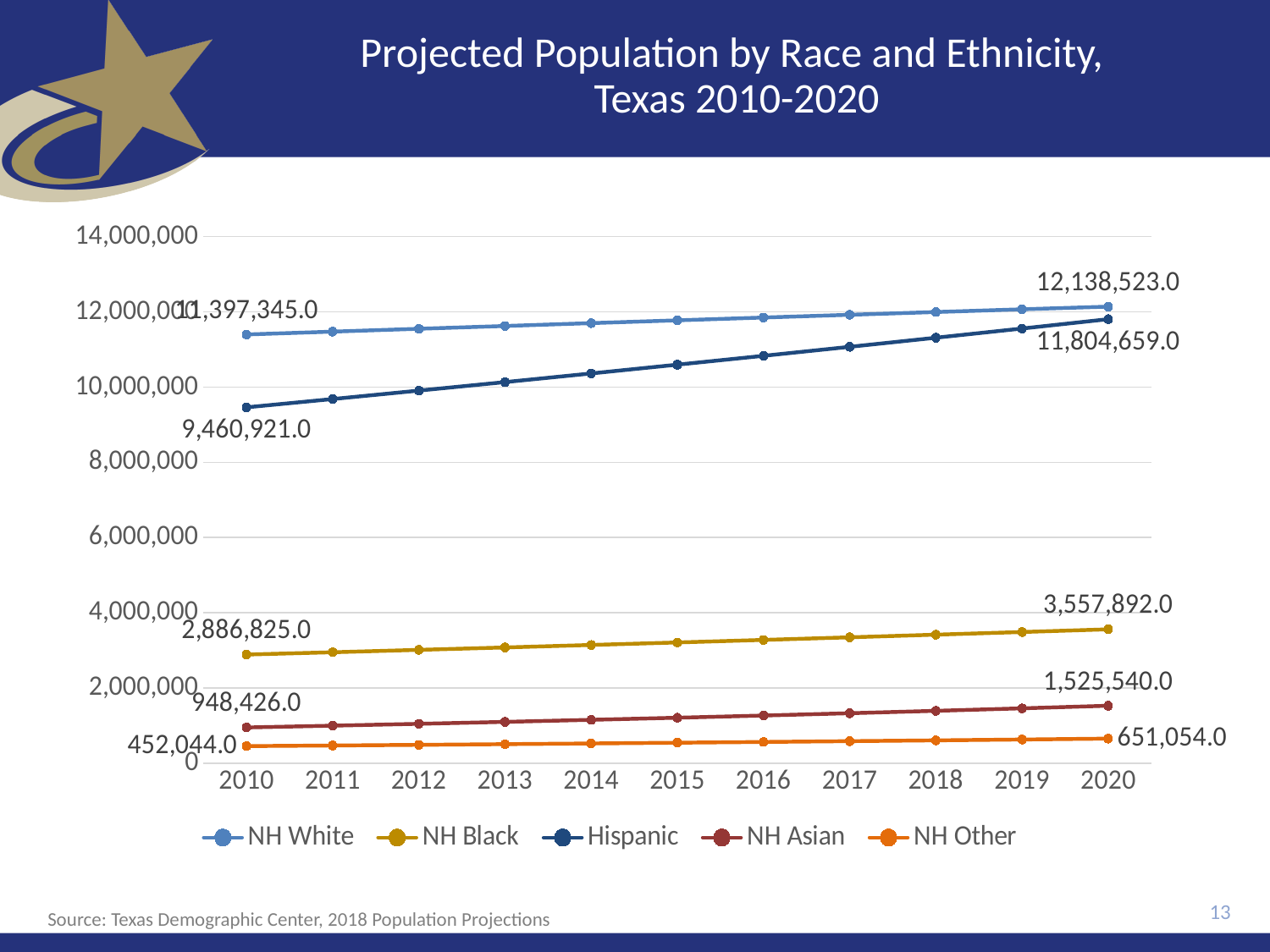
What is the projected NH White population in 2020? 12,138,523.0 What is the projected Hispanic population in 2010? 9,460,921.0 Is the Hispanic population in 2015 greater or less than 10,000,000? greater Which group has the lowest projected population across all years? NH Other By how much does the NH Asian population increase from 2010 to 2020? 577,114.0 How many years are plotted along the x axis? 11 What is the projected NH Black population in 2020? 3,557,892.0 Which group has the highest projected population in 2020? NH White How many series does the legend list? 5 What type of chart is shown on the slide? line chart What is the projected NH Other population in 2010? 452,044.0 By how much does the Hispanic population increase from 2010 to 2020? 2,343,738.0